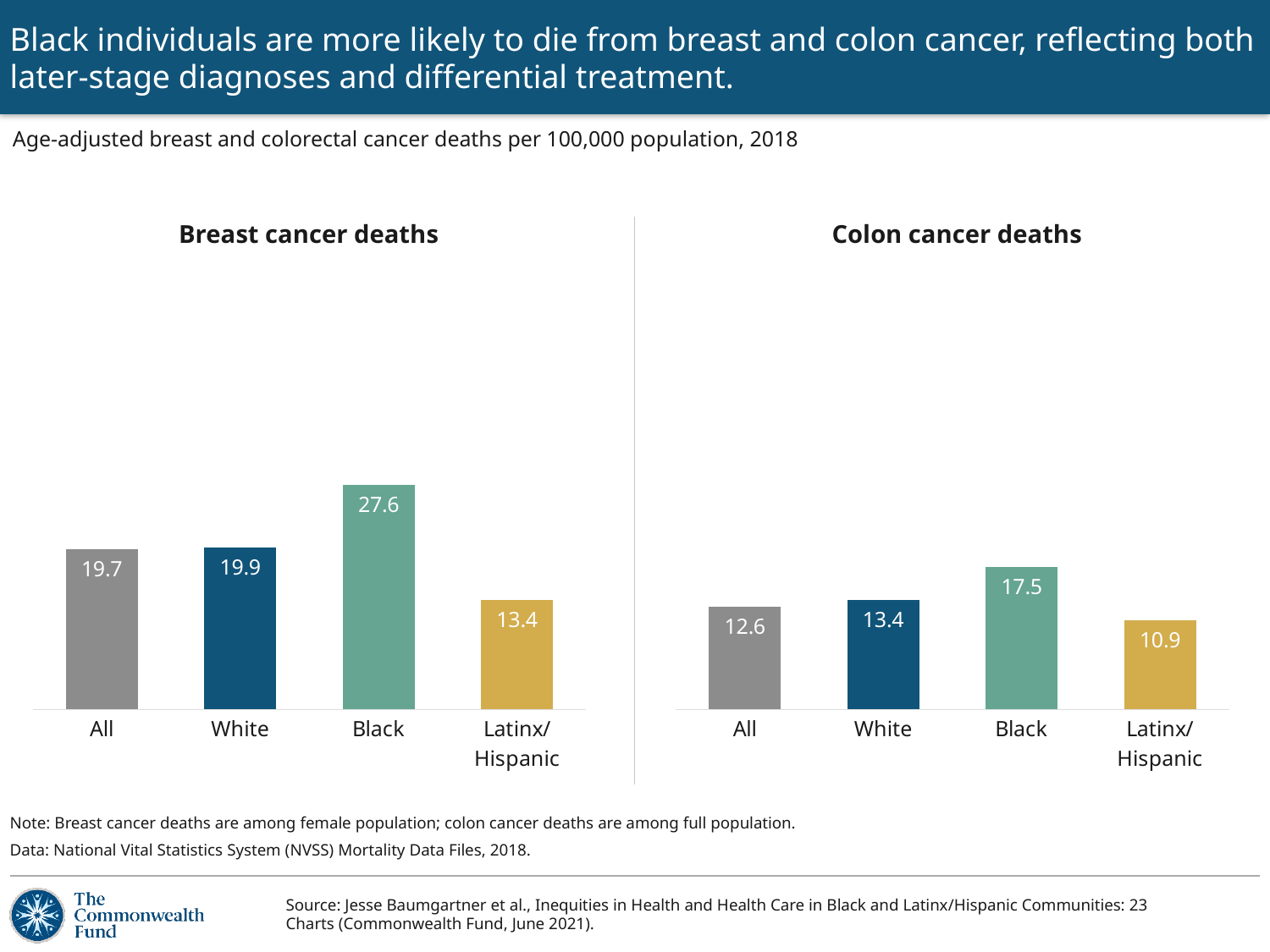
How many categories are shown in the Breast cancer deaths chart? 4 In the Breast cancer deaths chart, what is the value for Black? 27.6 In the Colon cancer deaths chart, which category has the lowest value? Latinx/Hispanic In the Breast cancer deaths chart, which category has the highest value? Black In the Colon cancer deaths chart, which is larger, the value for White or the value for All? White In the Colon cancer deaths chart, what is the value for Latinx/Hispanic? 10.9 In the Colon cancer deaths chart, what is the value for All? 12.6 What kind of chart is the Colon cancer deaths chart? Bar chart In the Breast cancer deaths chart, what is the value for Latinx/Hispanic? 13.4 In the Breast cancer deaths chart, what is the difference between the values for Black and White? 7.7 In the Colon cancer deaths chart, what is the difference between the values for Black and Latinx/Hispanic? 6.6 What is the title of the chart on the right side of the slide? Colon cancer deaths